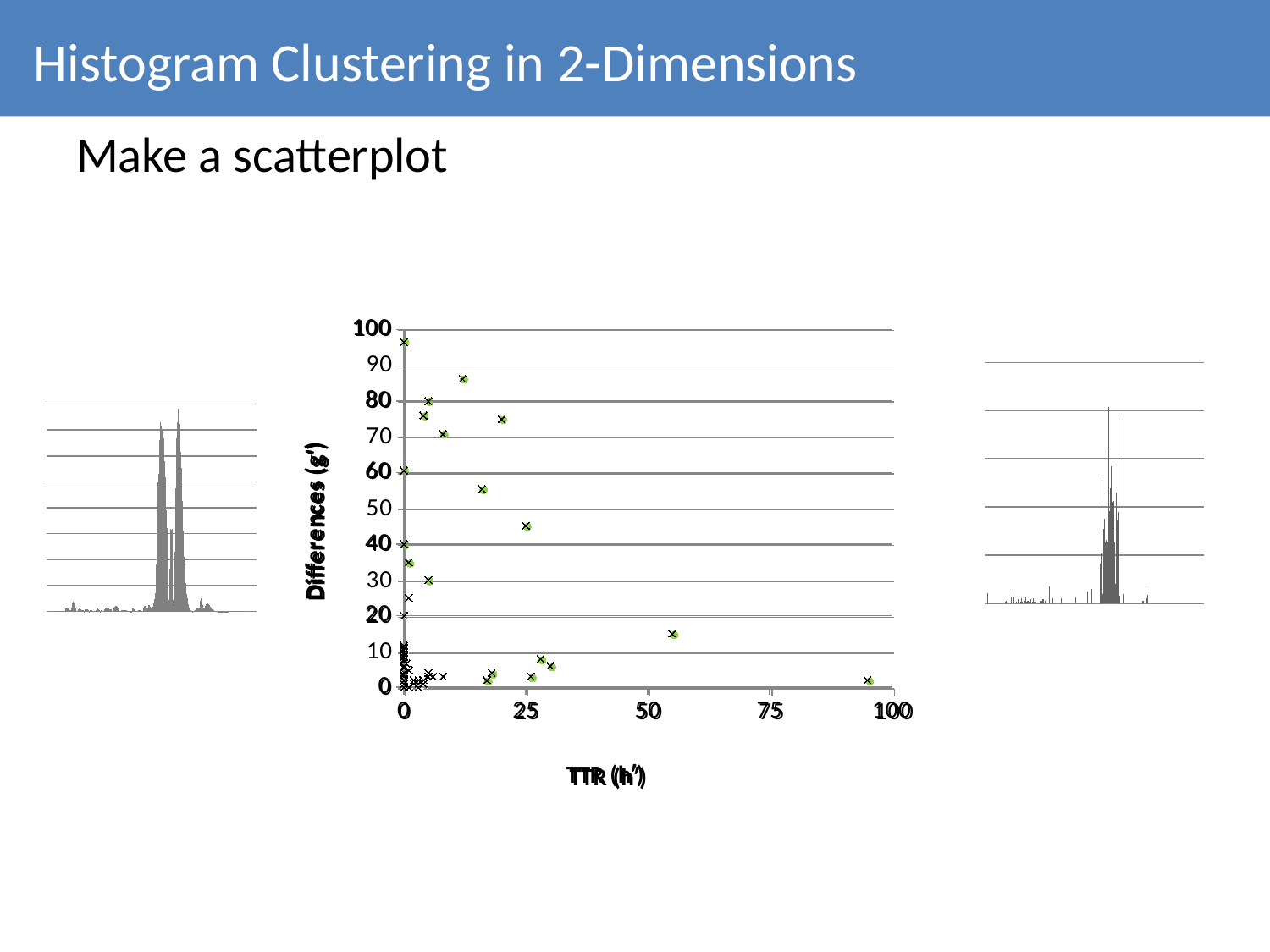
On the central scatter plot, is the y value of the point near x = 55 greater or less than 20? less What is the label of the x axis on the central scatter plot? TTR (h') On the central scatter plot, what is the maximum value shown on the y axis? 100 On the central scatter plot, is the x value of the rightmost point greater or less than 75? greater What is the label of the y axis on the central scatter plot? Differences (g') On the central scatter plot, is the y value of the highest point greater or less than 90? greater On the central scatter plot, do the points with the largest y values lie at small or large x values? small x values What kind of chart is the central chart on the slide? scatter plot